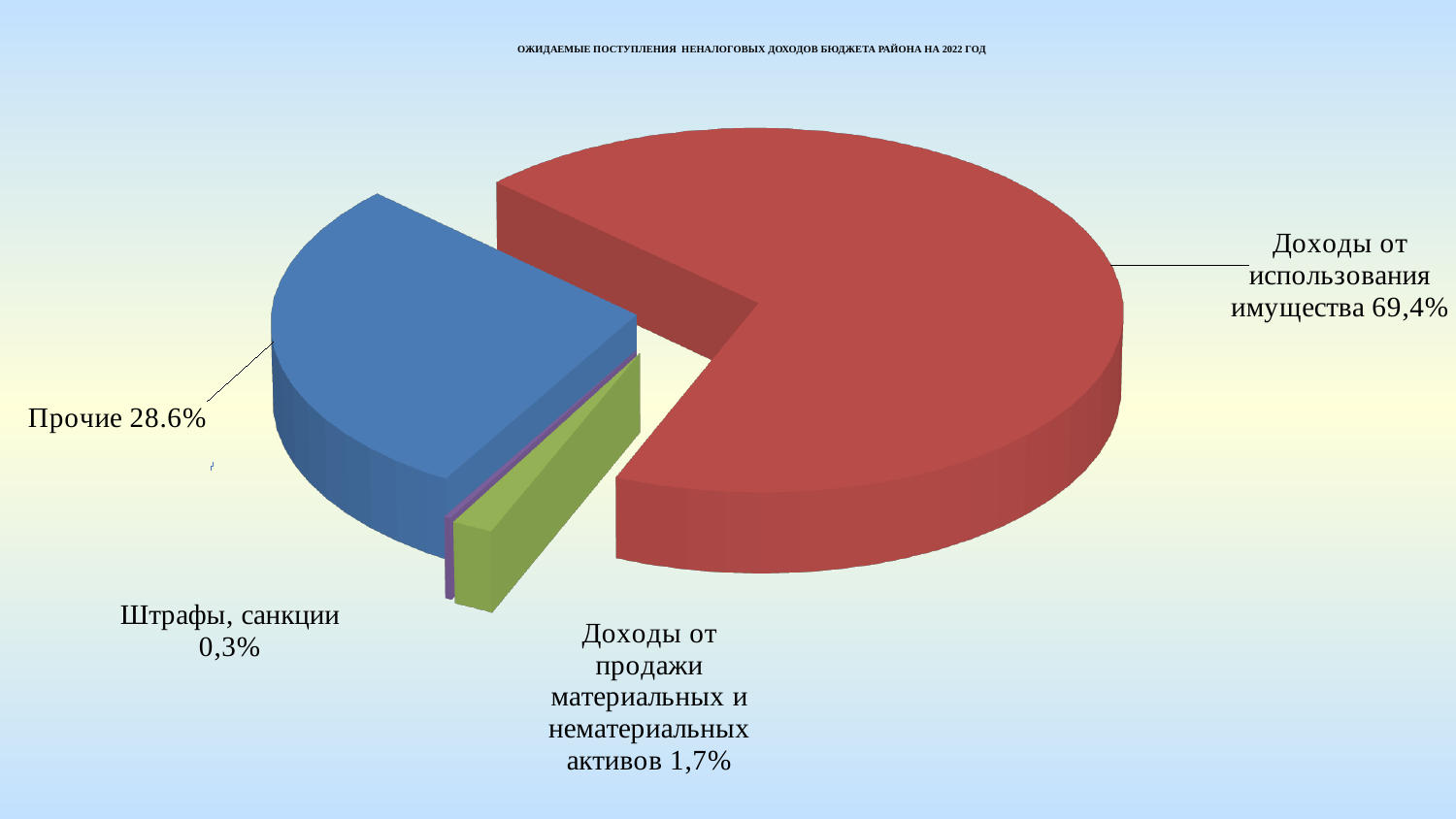
What is the difference in percentage points between "Доходы от использования имущества" and "Доходы от продажи материальных и нематериальных активов"? 67,7% What is the value shown for "Штрафы, санкции"? 0,3% What colour is the slice for "Прочие"? Blue What type of chart is shown on the slide? Pie chart What is the value shown for "Доходы от продажи материальных и нематериальных активов"? 1,7% What is the difference in percentage points between "Доходы от продажи материальных и нематериальных активов" and "Штрафы, санкции"? 1,4% Which category has the largest slice of the pie? Доходы от использования имущества What share of the pie does "Прочие" represent? 28.6% Which is larger: the share for "Прочие" or the share for "Доходы от продажи материальных и нематериальных активов"? Прочие What share of the pie does "Доходы от использования имущества" represent? 69,4% How many slices does the pie chart have? 4 Which category has the smallest slice of the pie? Штрафы, санкции